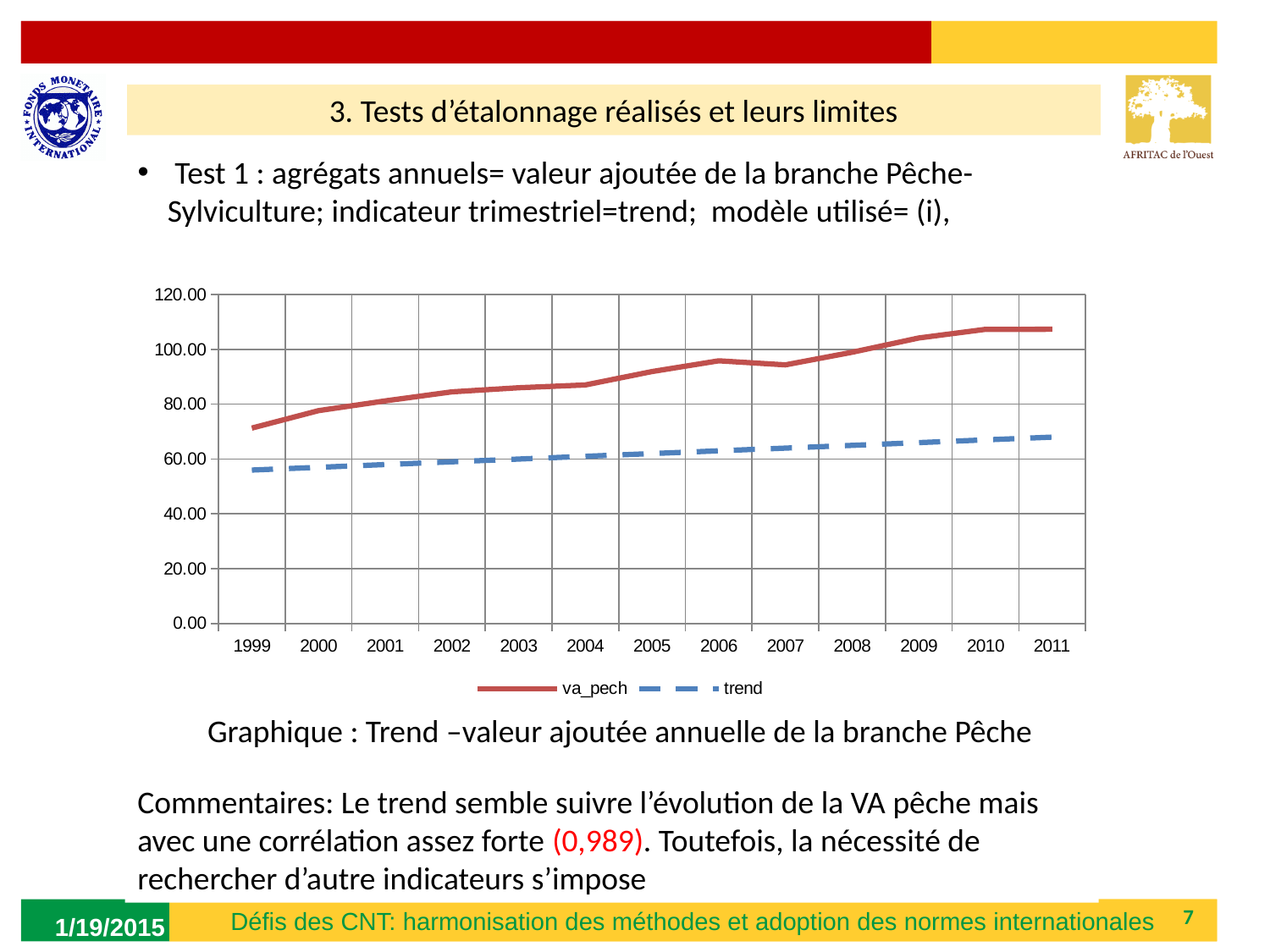
Is the value of va_pech in 2011 greater or less than 100? greater What are the names of the two series in the chart legend? va_pech and trend How many years are plotted along the x axis of the chart? 13 What kind of chart is shown on the slide? line chart How many series does the chart legend list? 2 Is the value of va_pech in 1999 greater or less than 80? less In 2005, which series has the larger value, va_pech or trend? va_pech Does the va_pech series rise or fall from 1999 to 2011? rise Does the trend series rise or fall from 1999 to 2011? rise Is the value of the trend series in 2011 greater or less than 60? greater In which year is the va_pech series at its lowest? 1999